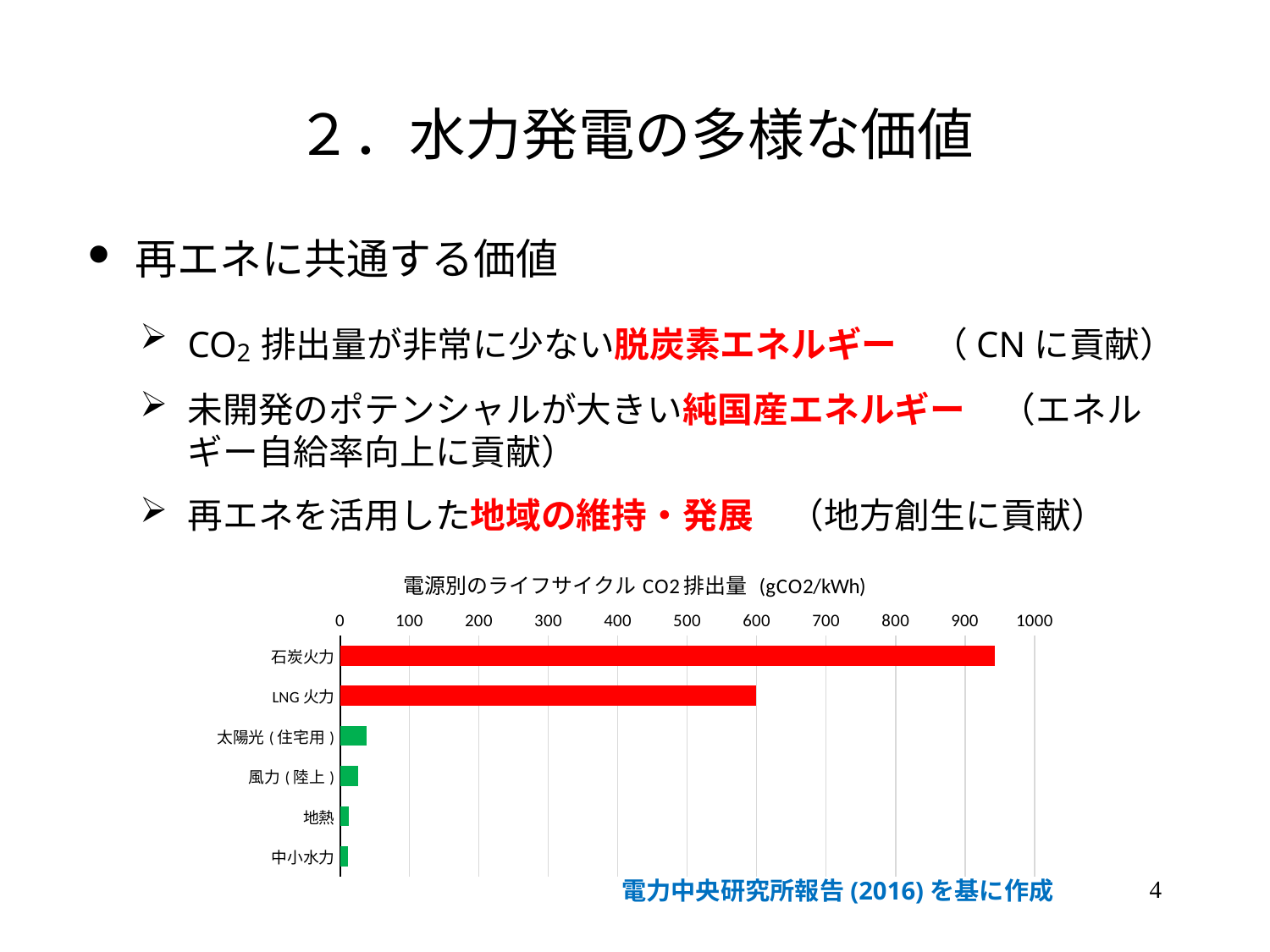
Which has the larger value, LNG火力 or 地熱? LNG火力 What is the title of the chart? 電源別のライフサイクルCO2排出量 (gCO2/kWh) Is the value for LNG火力 greater or less than 500? greater Is the value for 太陽光(住宅用) greater or less than 100? less Is the value for 石炭火力 greater or less than 900? greater What colour are the bars for 石炭火力 and LNG火力? red Which has the larger value, 石炭火力 or LNG火力? 石炭火力 Which has the larger value, 太陽光(住宅用) or 風力(陸上)? 太陽光(住宅用) How many power sources (categories) are plotted in the chart? 6 Which power source has the highest lifecycle CO2 emissions in the chart? 石炭火力 What kind of chart is shown on the slide? bar chart